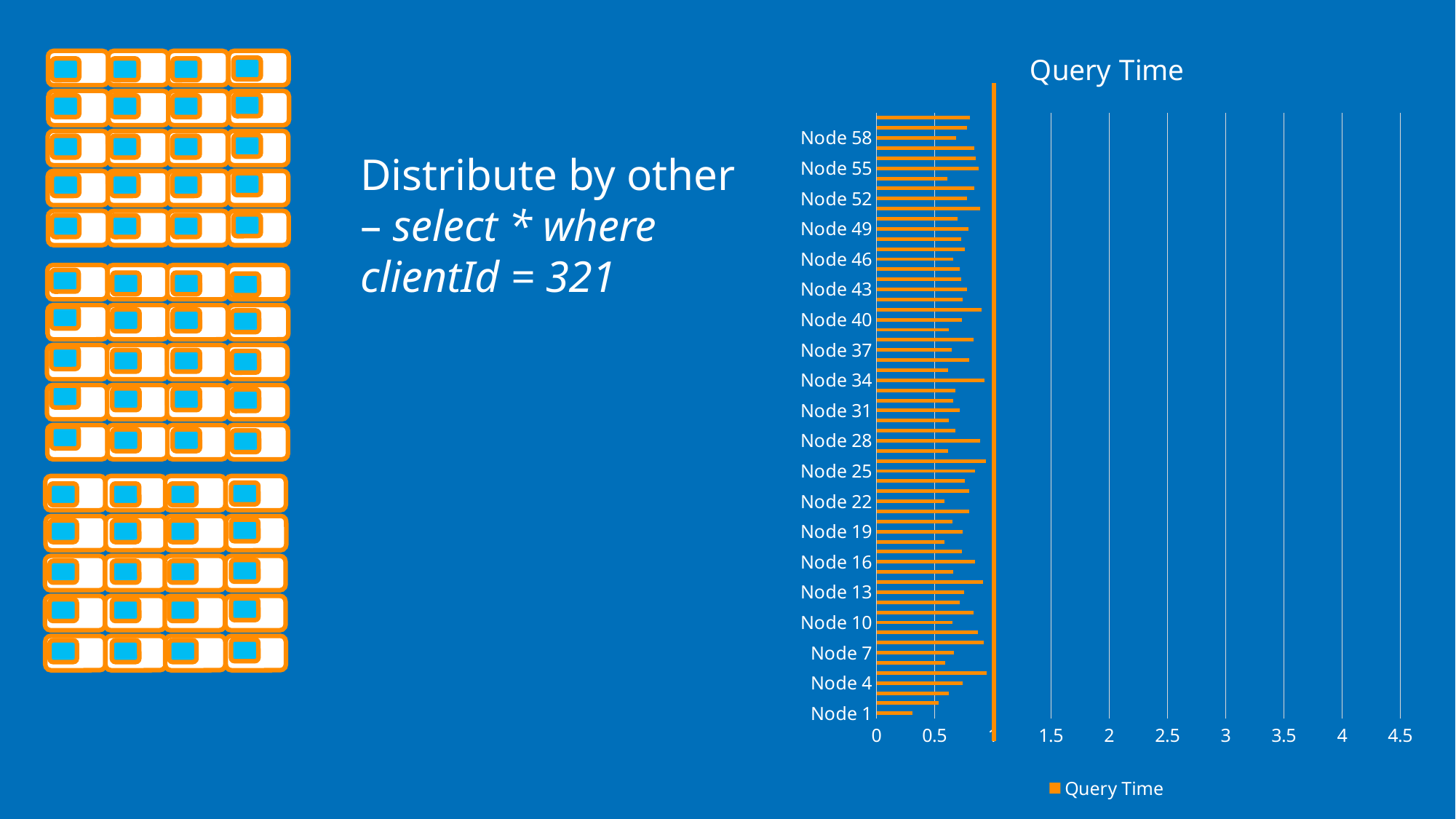
How many node labels are printed on the vertical axis of the chart? 20 Which has the larger query time, Node 1 or Node 4? Node 4 Is the value for Node 7 greater or less than 0.5? greater How many series does the chart legend list? 1 What kind of chart is shown on the slide? bar chart Is the value for Node 1 greater or less than 0.5? less Is the value for Node 31 greater or less than 1? less What is the title of the chart? Query Time Which node has the lowest query time in the chart? Node 1 What is the highest value shown on the horizontal axis of the chart? 4.5